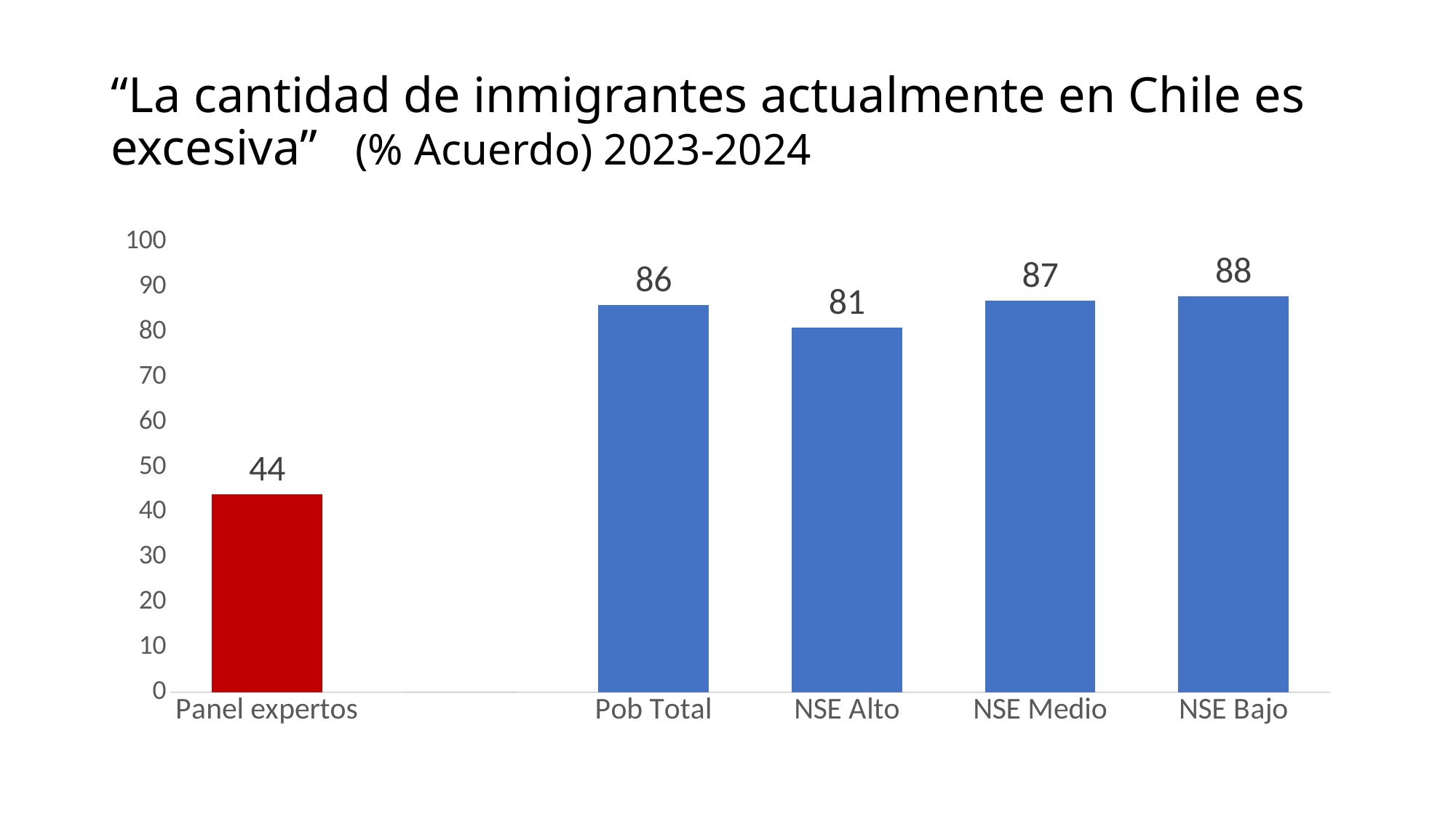
What is the difference between the values for NSE Bajo and Panel expertos? 44 Which is larger, the value for Pob Total or the value for NSE Alto? Pob Total What is the value for NSE Bajo? 88 Which bar is coloured red? Panel expertos Which category has the highest value? NSE Bajo What kind of chart is shown on the slide? bar chart What is the value for NSE Alto? 81 Which category has the lowest value? Panel expertos What is the difference between the values for NSE Medio and NSE Alto? 6 How many categories are shown on the x axis? 5 What is the value for Panel expertos? 44 What is the value for Pob Total? 86